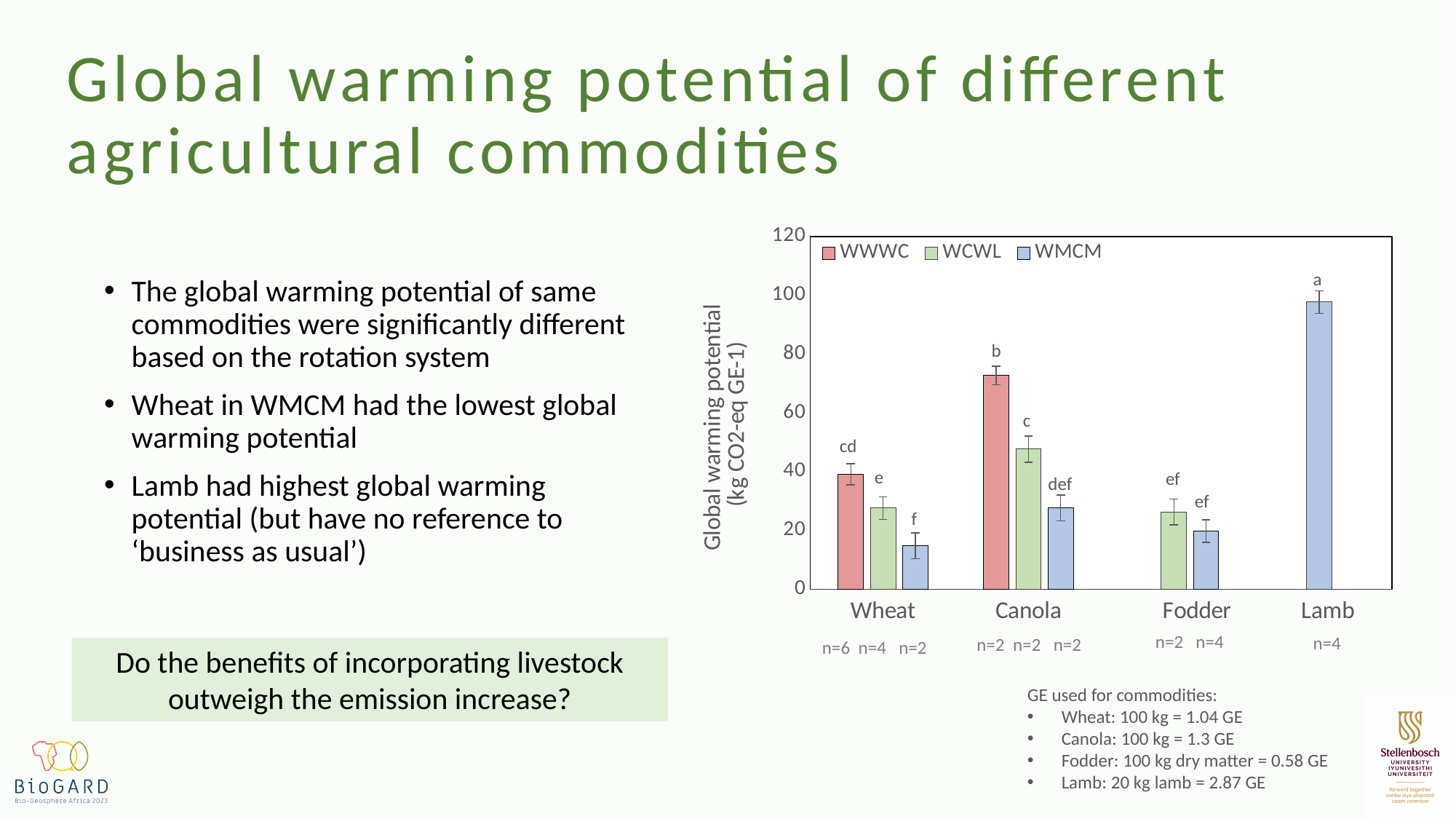
What kind of chart is shown on the slide? bar chart Which bar in the chart has the lowest global warming potential? Wheat in WMCM What are the three series names listed in the chart legend? WWWC, WCWL, WMCM Which is larger: the global warming potential of Wheat in WWWC or Fodder in WCWL? Wheat in WWWC Which commodity has the highest global warming potential bar in the chart? Lamb Is the global warming potential for Lamb (WMCM) greater or less than 80? greater Which series is the only one with a bar for Lamb? WMCM Is the global warming potential for Canola in WWWC greater or less than 60? greater Is the global warming potential for Wheat in WMCM greater or less than 20? less For Canola, which rotation system has the larger global warming potential, WWWC or WCWL? WWWC How many series does the chart legend list? 3 How many commodity categories are shown on the x axis of the chart? 4